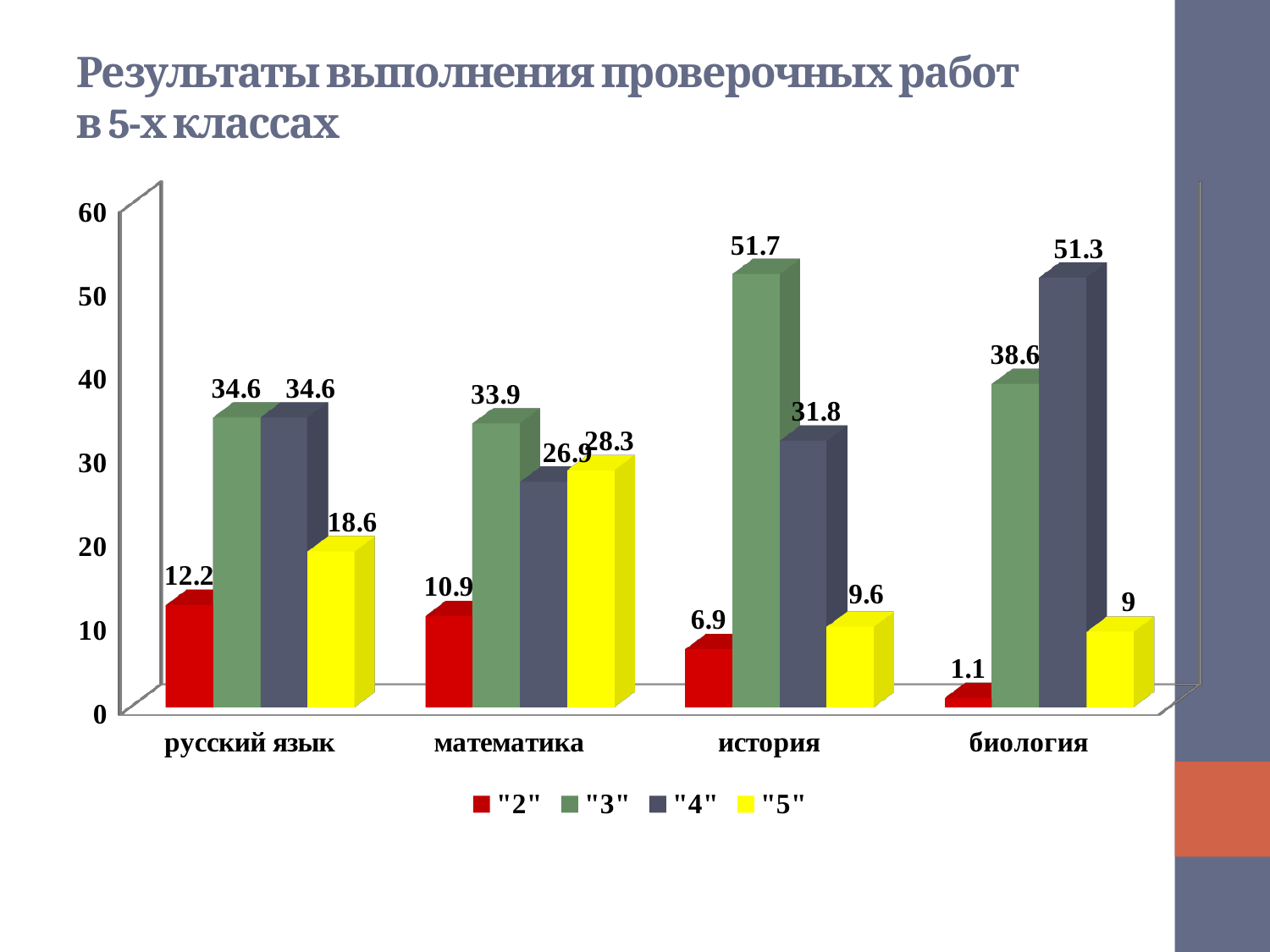
Which subject has the lowest value for "2"? биология What type of chart is shown on the slide? bar chart What is the difference between the "3" and "4" values in история? 19.9 What is the value for "2" in русский язык? 12.2 How many series does the legend list? 4 What is the value for "4" in биология? 51.3 Which subject has the highest value for "3"? история What is the value for "5" in математика? 28.3 Which is larger in биология: the value for "3" or the value for "4"? "4" What is the title of the slide? Результаты выполнения проверочных работ в 5-х классах What is the value for "3" in история? 51.7 How many subject categories are shown on the x axis? 4